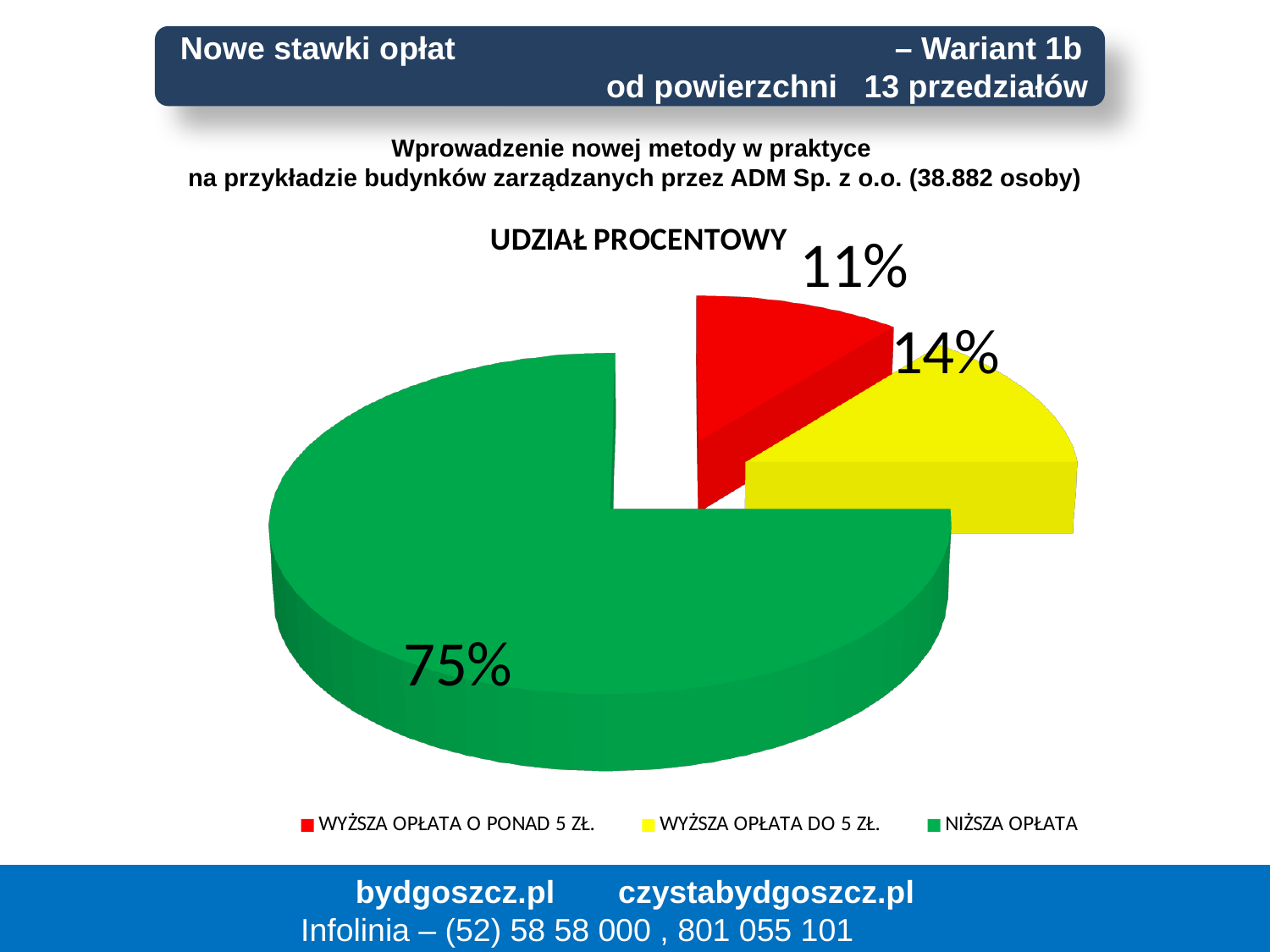
What is the title of the chart? UDZIAŁ PROCENTOWY What is the difference in percentage points between the NIŻSZA OPŁATA slice and the WYŻSZA OPŁATA DO 5 ZŁ. slice? 61 percentage points What colour is the NIŻSZA OPŁATA slice? Green What percentage share does the NIŻSZA OPŁATA slice have? 75% How many slices does the pie chart have? 3 What type of chart is shown on the slide? Pie chart Which category has the smallest share of the pie? WYŻSZA OPŁATA O PONAD 5 ZŁ. What percentage share does the WYŻSZA OPŁATA O PONAD 5 ZŁ. slice have? 11% What percentage share does the WYŻSZA OPŁATA DO 5 ZŁ. slice have? 14% How many entries does the legend list? 3 Which category has the largest share of the pie? NIŻSZA OPŁATA Which is larger: the share for WYŻSZA OPŁATA DO 5 ZŁ. or the share for WYŻSZA OPŁATA O PONAD 5 ZŁ.? WYŻSZA OPŁATA DO 5 ZŁ.